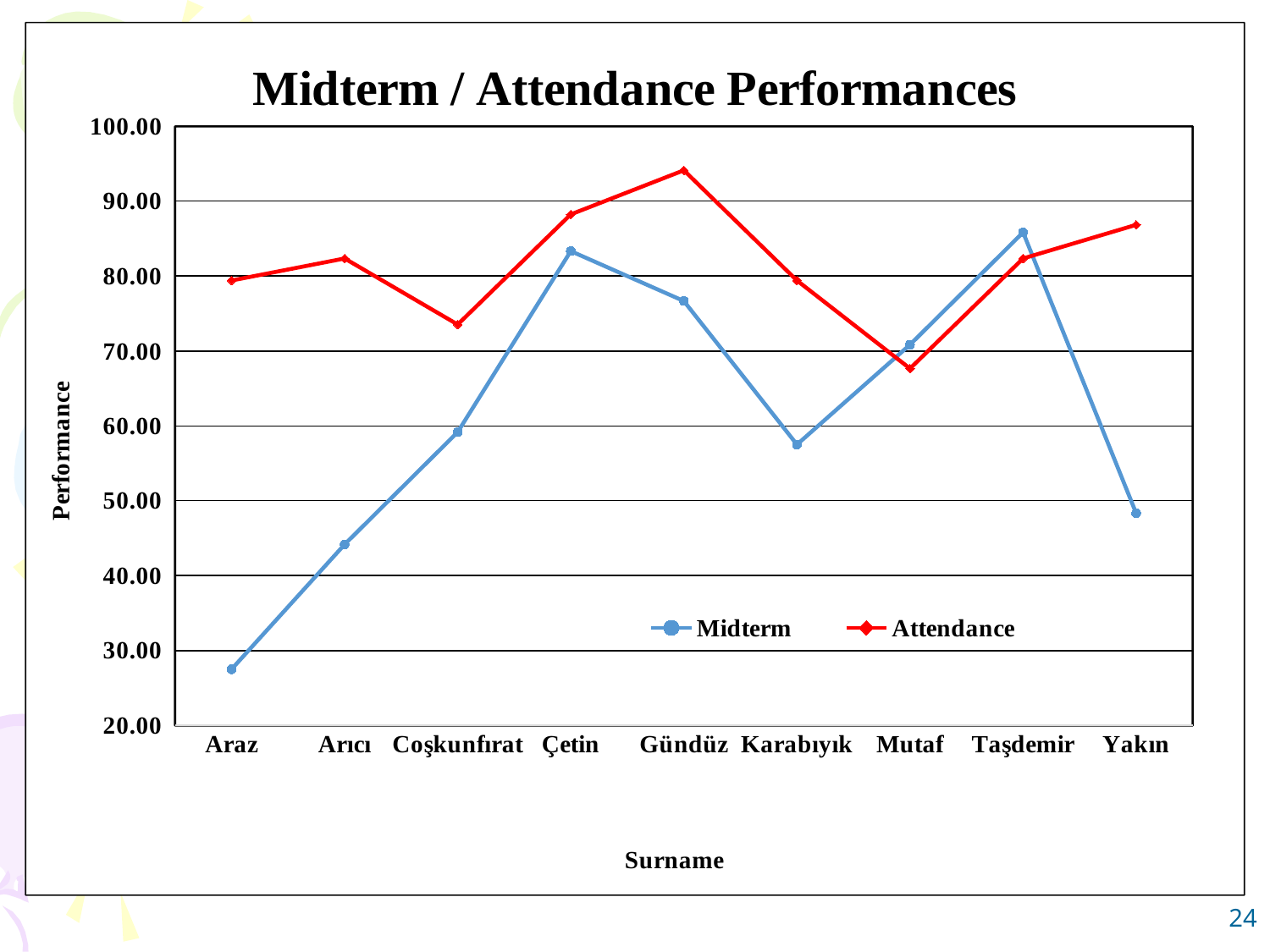
Which surname has the lowest Midterm value? Araz Is the Attendance value for Gündüz greater or less than 90.00? greater How many surnames are plotted along the x axis? 9 For Taşdemir, which is larger: the Midterm value or the Attendance value? Midterm For Araz, which is larger: the Midterm value or the Attendance value? Attendance Is the Midterm value for Yakın greater or less than 50.00? less What kind of chart is shown on the slide? Line chart Which surname has the lowest Attendance value? Mutaf How many series does the legend list? 2 Which surname has the highest Attendance value? Gündüz Is the Midterm value for Araz greater or less than 30.00? less Does the Midterm line rise or fall from Araz to Çetin? Rise